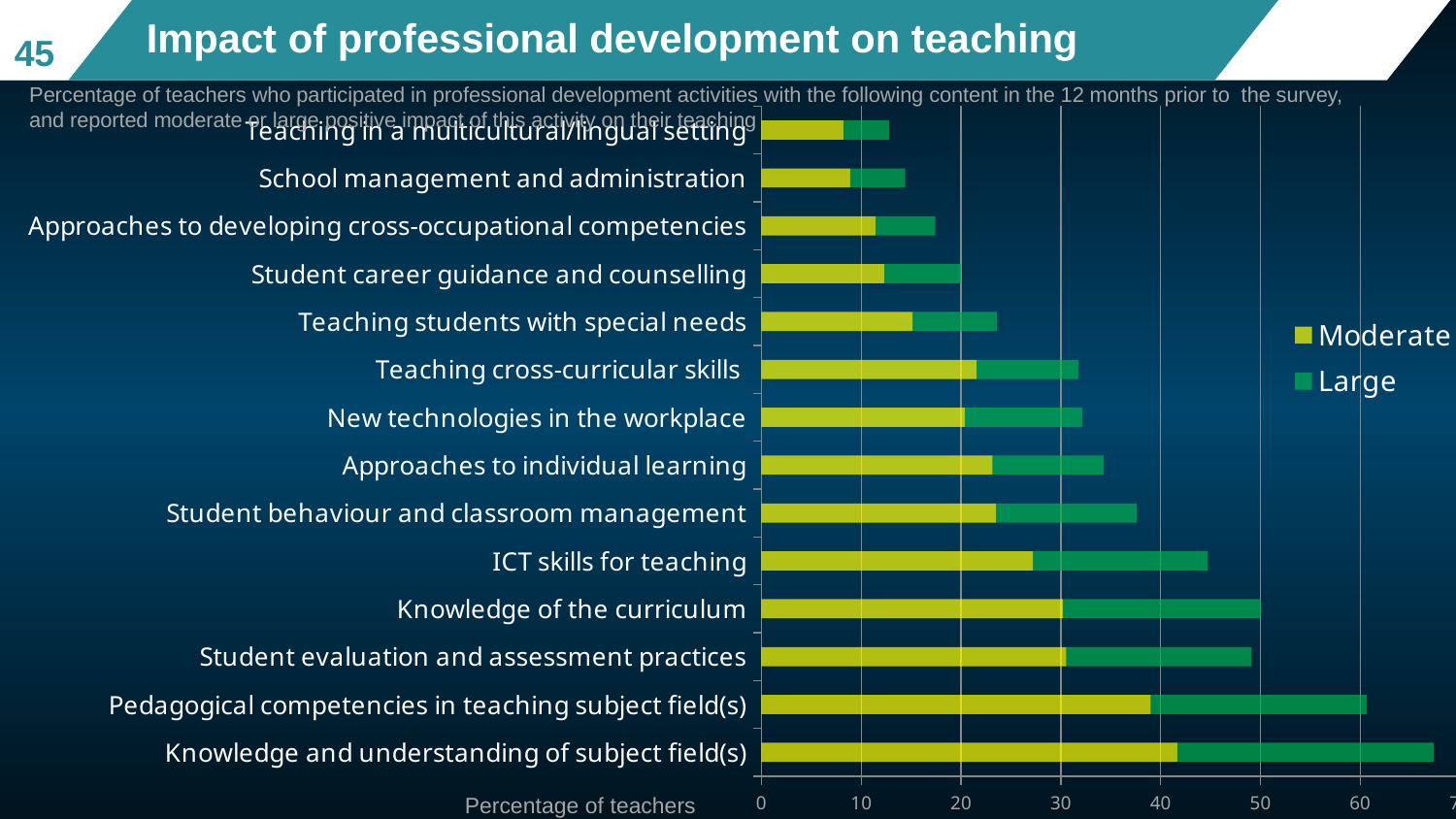
What are the two entries in the chart legend? Moderate, Large Which category has the longest total bar? Knowledge and understanding of subject field(s) What is the label on the horizontal axis of the chart? Percentage of teachers Which category has the shortest total bar? Teaching in a multicultural/lingual setting How many professional development content categories are plotted on the chart? 14 Is the total value for School management and administration greater or less than 20? less Is the total value for Student behaviour and classroom management greater or less than 40? less Which has the larger total bar: Pedagogical competencies in teaching subject field(s) or Student evaluation and assessment practices? Pedagogical competencies in teaching subject field(s) Is the total value for ICT skills for teaching greater or less than 40? greater What kind of chart is shown on the slide? Stacked bar chart How many series does the legend list? 2